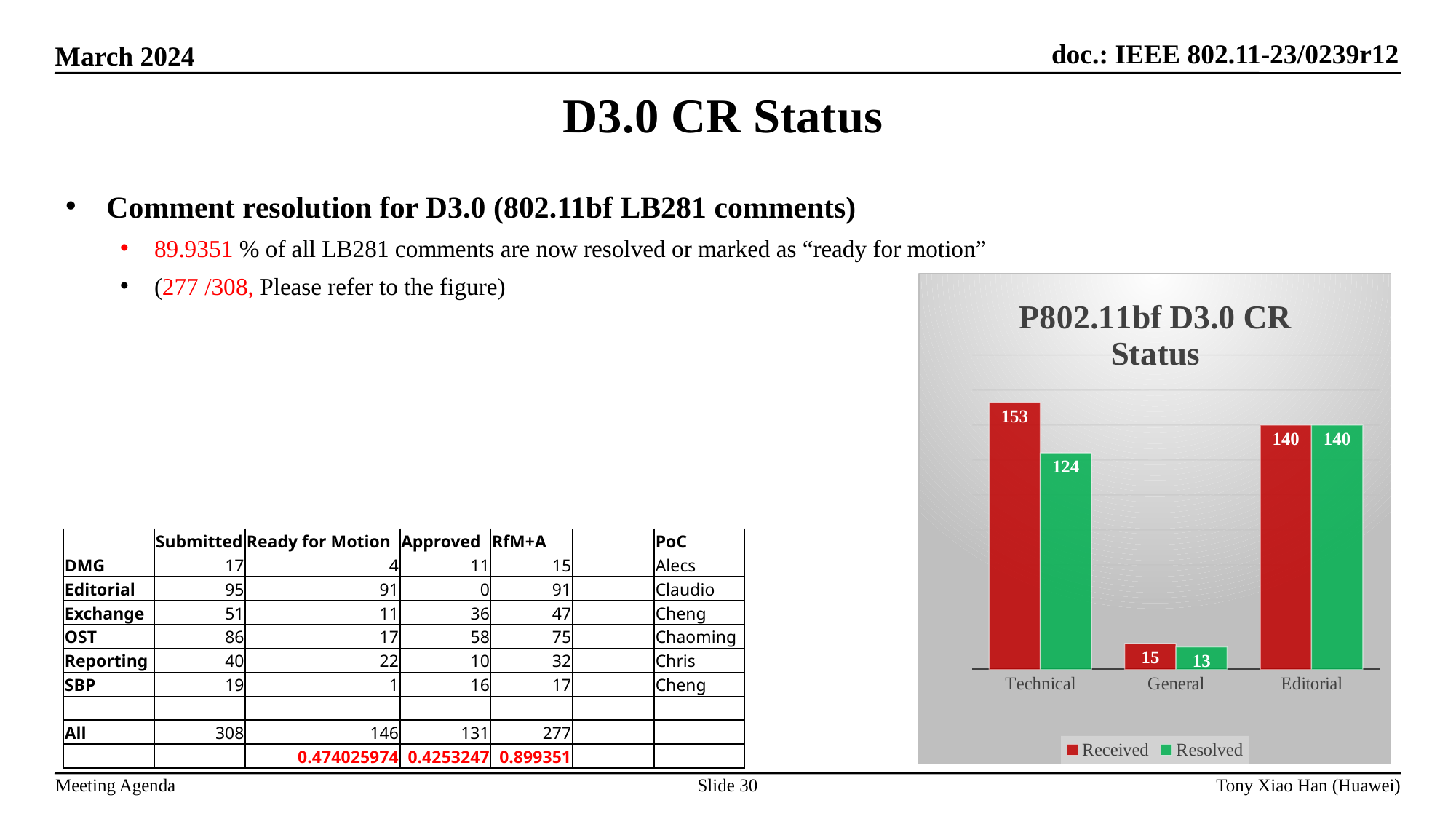
What is the Received value for General in the chart? 15 What is the difference between Received and Resolved for Technical in the chart? 29 What is the difference between Received and Resolved for General in the chart? 2 What is the Received value for Technical in the P802.11bf D3.0 CR Status chart? 153 Which category has the lowest Resolved value in the chart? General Which category has the highest Received value in the chart? Technical Is the Resolved value for Technical larger or smaller than the Resolved value for Editorial? smaller What is the Resolved value for Technical in the chart? 124 What is the Resolved value for Editorial in the chart? 140 How many categories are shown on the x axis of the chart? 3 What type of chart is shown on the slide? bar chart How many series does the chart legend list? 2